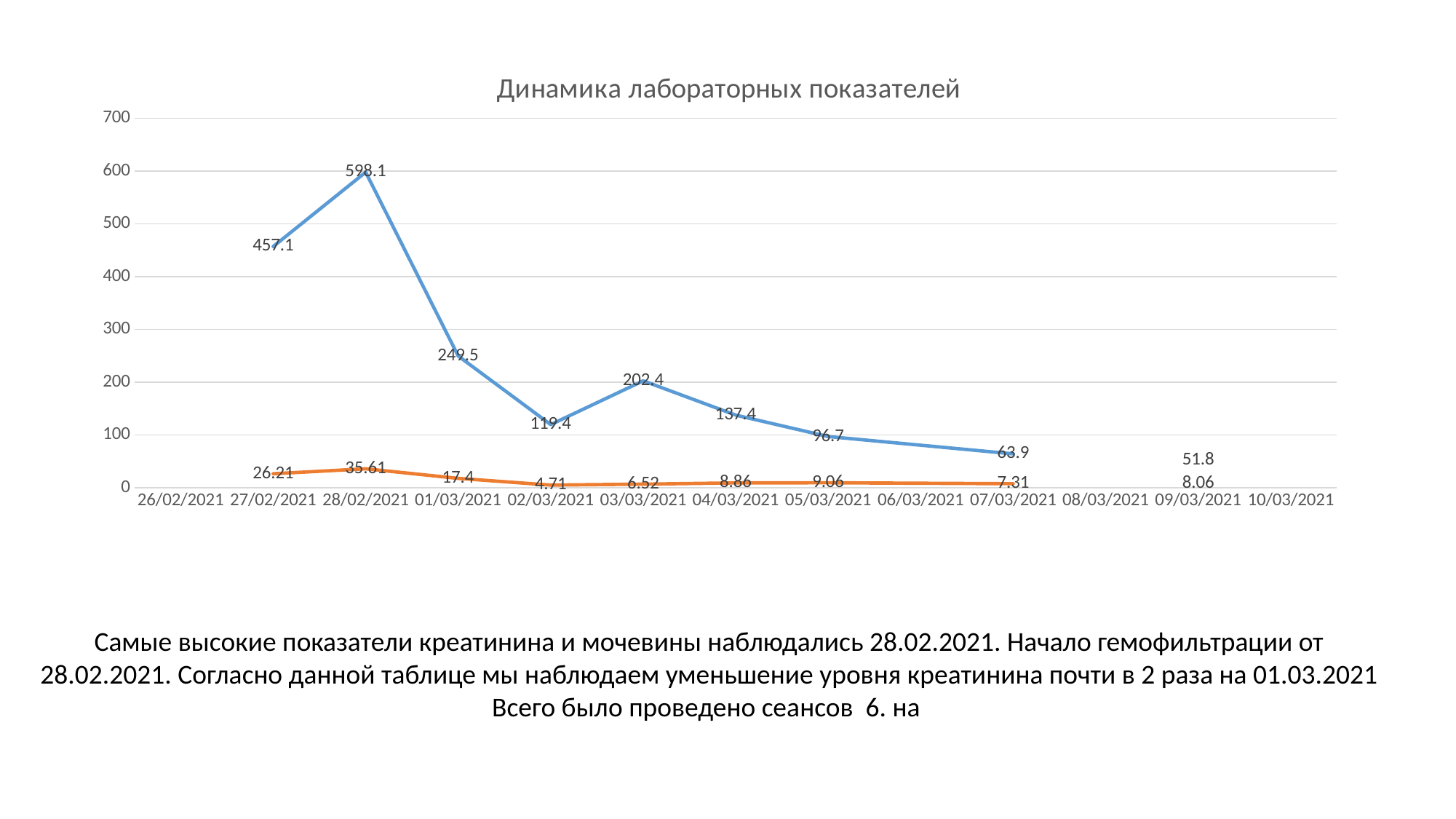
Is the value of the blue line on 01/03/2021 greater or less than 200? greater On which date does the orange line reach its lowest value? 02/03/2021 What is the title of the chart? Динамика лабораторных показателей Does the blue line rise or fall from 03/03/2021 to 07/03/2021? fall What is the difference between the orange line's values on 28/02/2021 and 27/02/2021? 9.4 What is the value of the blue line on 07/03/2021? 63.9 By how much does the blue line's value on 28/02/2021 exceed its value on 27/02/2021? 141 For the blue line, which date has the larger value: 02/03/2021 or 03/03/2021? 03/03/2021 What is the value of the orange line on 02/03/2021? 4.71 What kind of chart is shown on the slide? line chart What is the value of the blue line on 28/02/2021? 598.1 On which date does the blue line reach its highest value? 28/02/2021